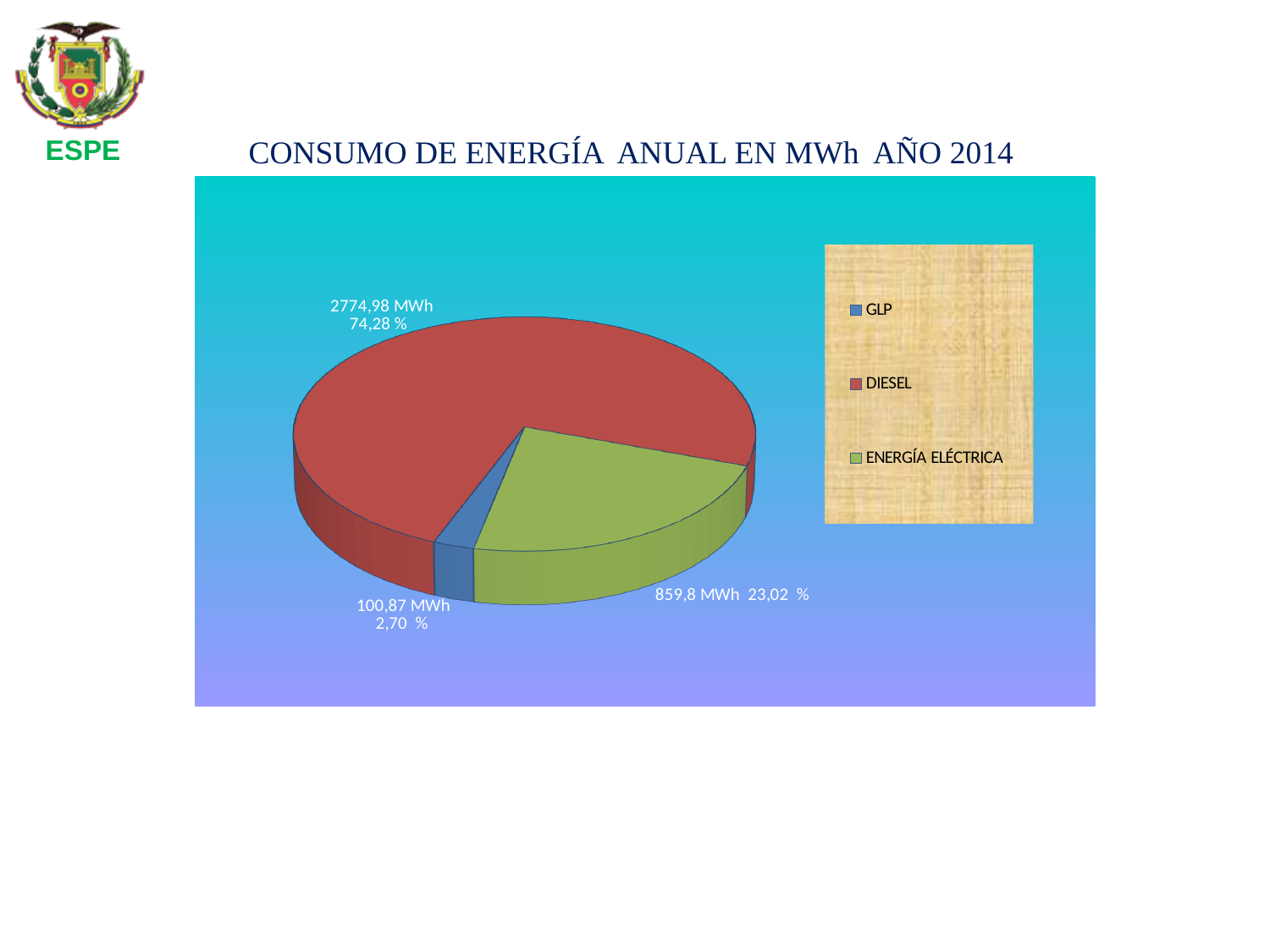
Which energy source has the lowest consumption? GLP What is the difference in consumption between DIESEL and ENERGÍA ELÉCTRICA? 1915,18 MWh What share of the pie does GLP represent? 2,70 % How many categories does the pie chart show? 3 What type of chart is shown on the slide? pie chart What share of the pie does ENERGÍA ELÉCTRICA represent? 23,02 % What is the energy consumption value for ENERGÍA ELÉCTRICA? 859,8 MWh Which has a larger consumption, ENERGÍA ELÉCTRICA or GLP? ENERGÍA ELÉCTRICA What share of the pie does DIESEL represent? 74,28 % What is the energy consumption value for GLP? 100,87 MWh What is the energy consumption value for DIESEL? 2774,98 MWh Which energy source has the highest consumption? DIESEL